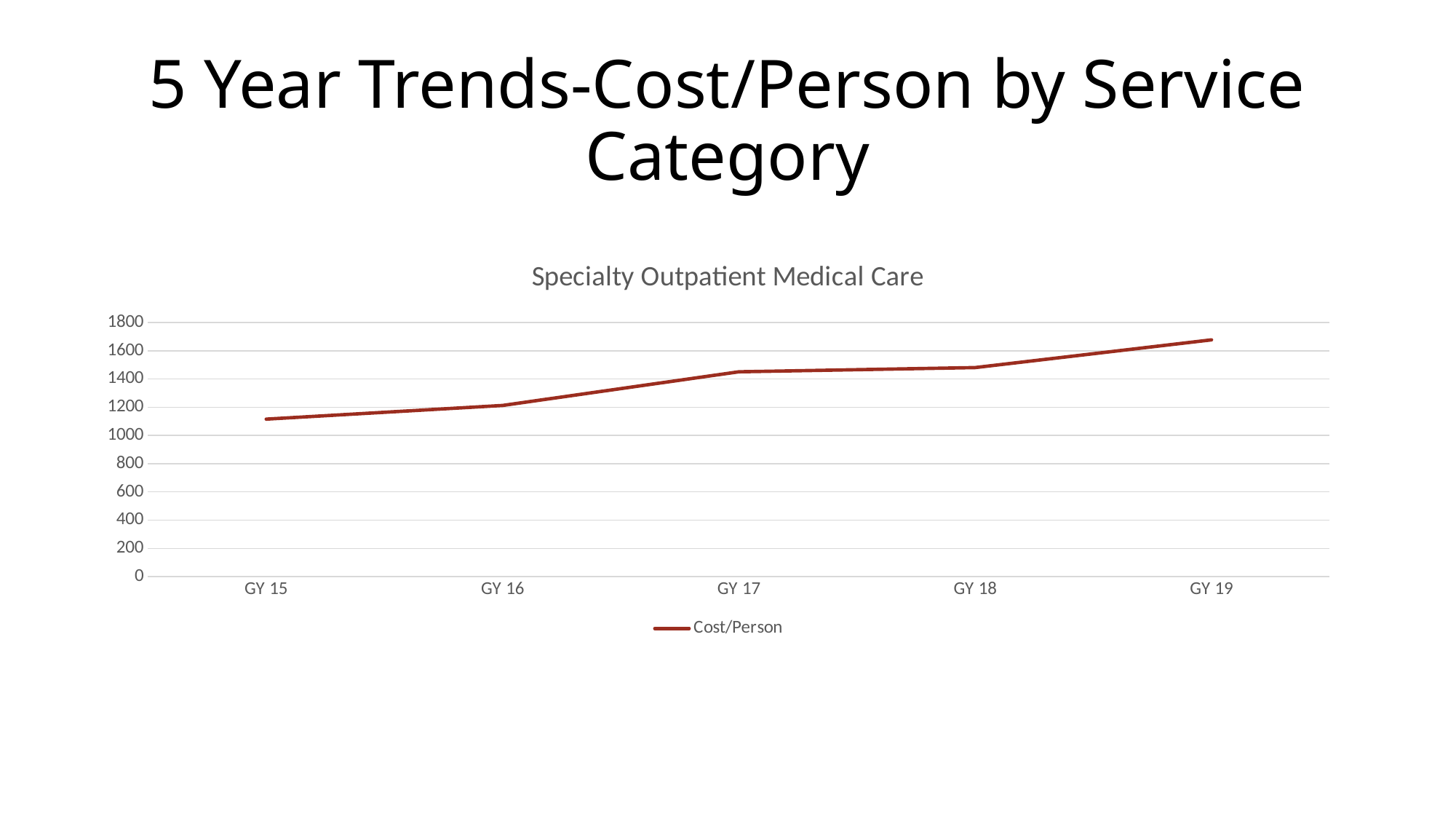
How many series does the legend list? 1 Is the Cost/Person for GY 15 greater or less than 1200? less Which year has the highest Cost/Person? GY 19 What type of chart is shown on the slide? line chart What is the title of the chart? Specialty Outpatient Medical Care Is the Cost/Person for GY 19 greater or less than 1600? greater Which year has the larger Cost/Person, GY 16 or GY 17? GY 17 What is the name of the series shown in the legend? Cost/Person Is the Cost/Person for GY 17 greater or less than 1400? greater Which year has the lowest Cost/Person? GY 15 How many years (data points) are plotted on the x axis? 5 Does the Cost/Person rise or fall from GY 15 to GY 19? rise